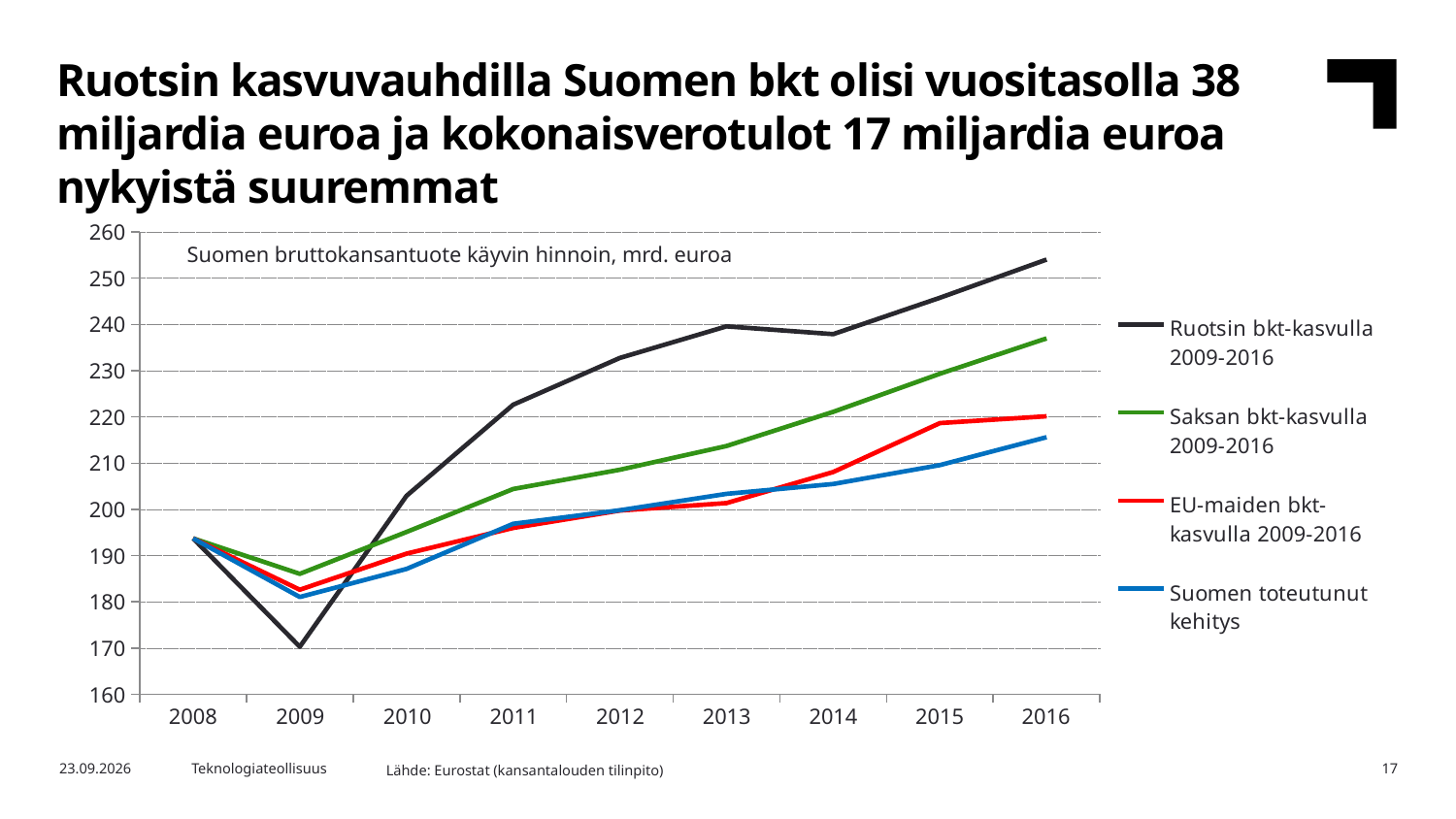
In 2016, which is larger: 'Ruotsin bkt-kasvulla 2009-2016' or 'Saksan bkt-kasvulla 2009-2016'? Ruotsin bkt-kasvulla 2009-2016 How many series does the legend list? 4 Is the value for 'Ruotsin bkt-kasvulla 2009-2016' in 2009 greater or less than 180? less Which series has the lowest value in 2016? Suomen toteutunut kehitys What is the text shown inside the plot area describing the chart? Suomen bruttokansantuote käyvin hinnoin, mrd. euroa What kind of chart is shown on the slide? line chart Is the value for 'Ruotsin bkt-kasvulla 2009-2016' in 2016 greater or less than 250? greater Which series has the highest value in 2016? Ruotsin bkt-kasvulla 2009-2016 Is the value for 'Saksan bkt-kasvulla 2009-2016' in 2016 greater or less than 230? greater In which year does the 'Ruotsin bkt-kasvulla 2009-2016' series reach its lowest value? 2009 How many years are shown on the x axis? 9